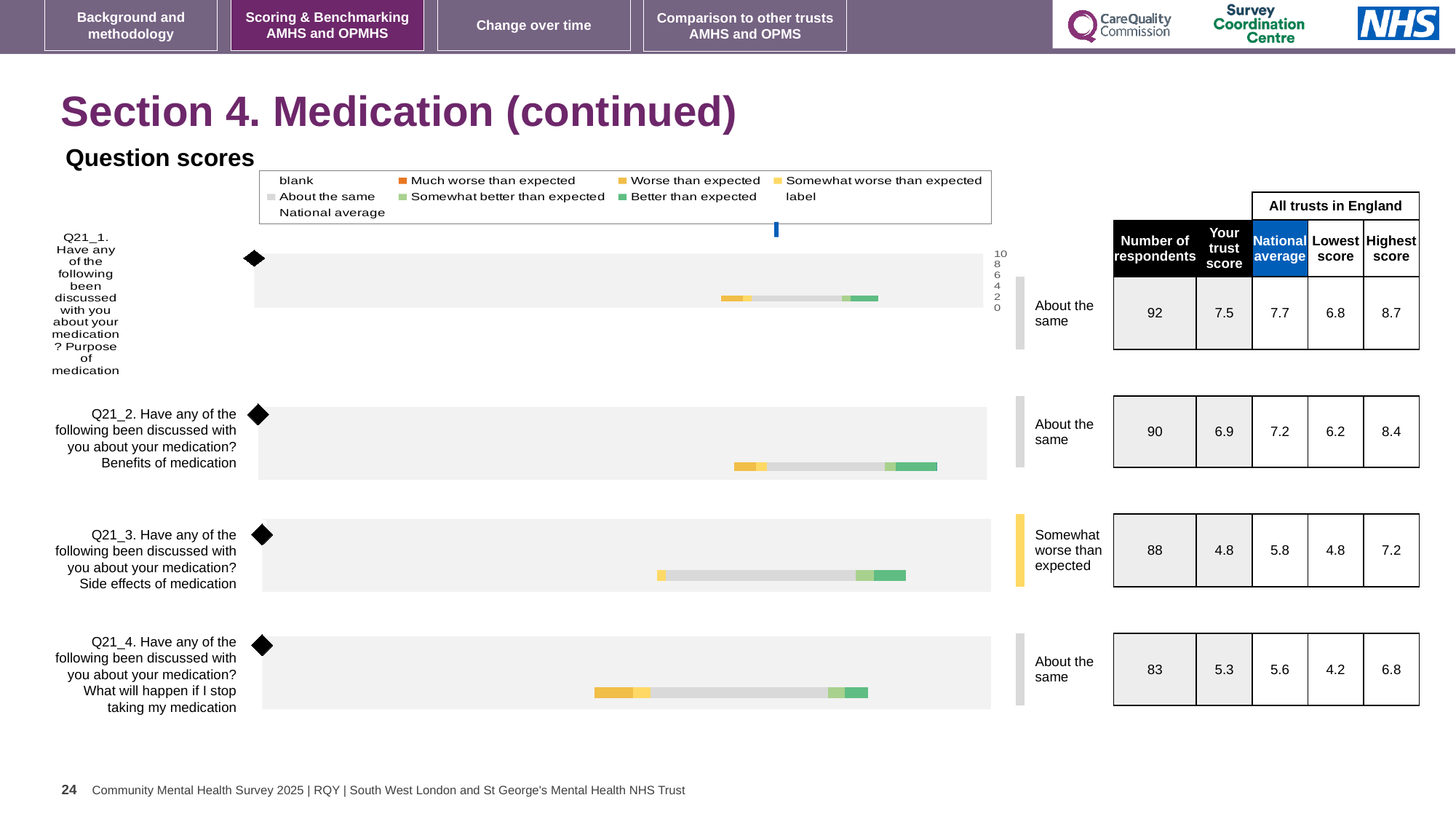
Which benchmark category is Q21_3 (Side effects of medication) rated as? Somewhat worse than expected How many question rows (Q21_1 to Q21_4) are plotted on the slide? 4 Which question has the highest trust score? Q21_1 (Purpose of medication) Which question has the lowest trust score? Q21_3 (Side effects of medication) How many respondents answered Q21_4 (What will happen if I stop taking my medication)? 83 For Q21_2 (Benefits of medication), what is the difference between the national average and the trust score? 0.3 What kind of chart is used to show the question scores on this slide? bar chart What is the trust score for Q21_1 (Purpose of medication)? 7.5 What is the highest score among all trusts in England for Q21_2 (Benefits of medication)? 8.4 How many of the four questions are rated 'About the same'? 3 For Q21_4 (What will happen if I stop taking my medication), which is larger: the trust score or the national average? National average What is the national average for Q21_3 (Side effects of medication)? 5.8